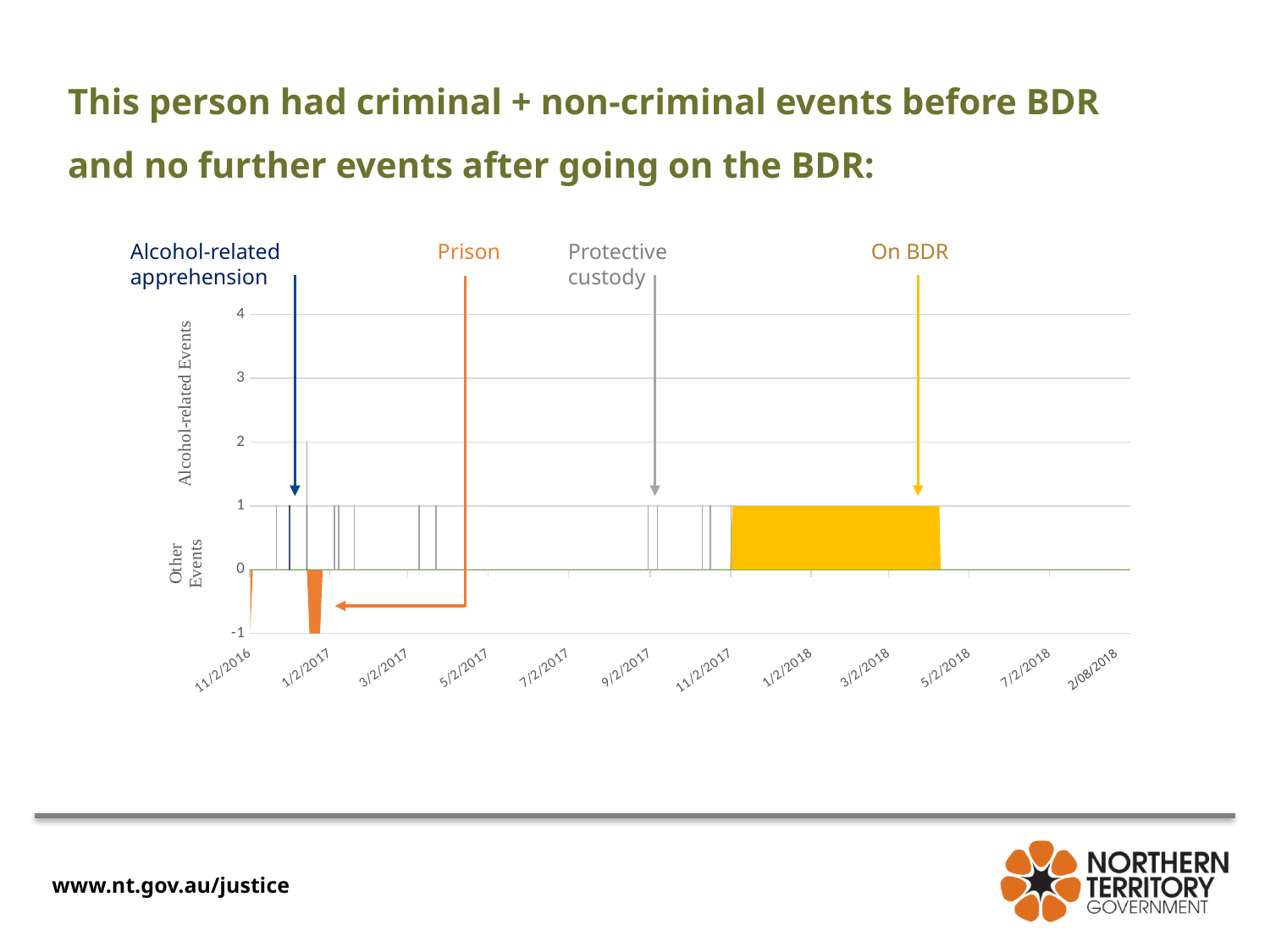
What is the lowest value shown on the vertical axis of the chart? -1 What is the highest value shown on the vertical axis of the chart? 4 What is the first date label on the x axis of the chart? 11/2/2016 Are there any events plotted after the On BDR period ends? No What is the label of the upper vertical axis of the chart? Alcohol-related Events How many date labels are shown along the x axis of the chart? 12 Which event type is shown in yellow on the chart? On BDR What is the last date label on the x axis of the chart? 2/08/2018 Which annotated event type occurs earliest on the timeline? Prison Does the Prison event occur before or after 3/2/2017 on the chart? before How many event types are annotated with arrows above the chart? 4